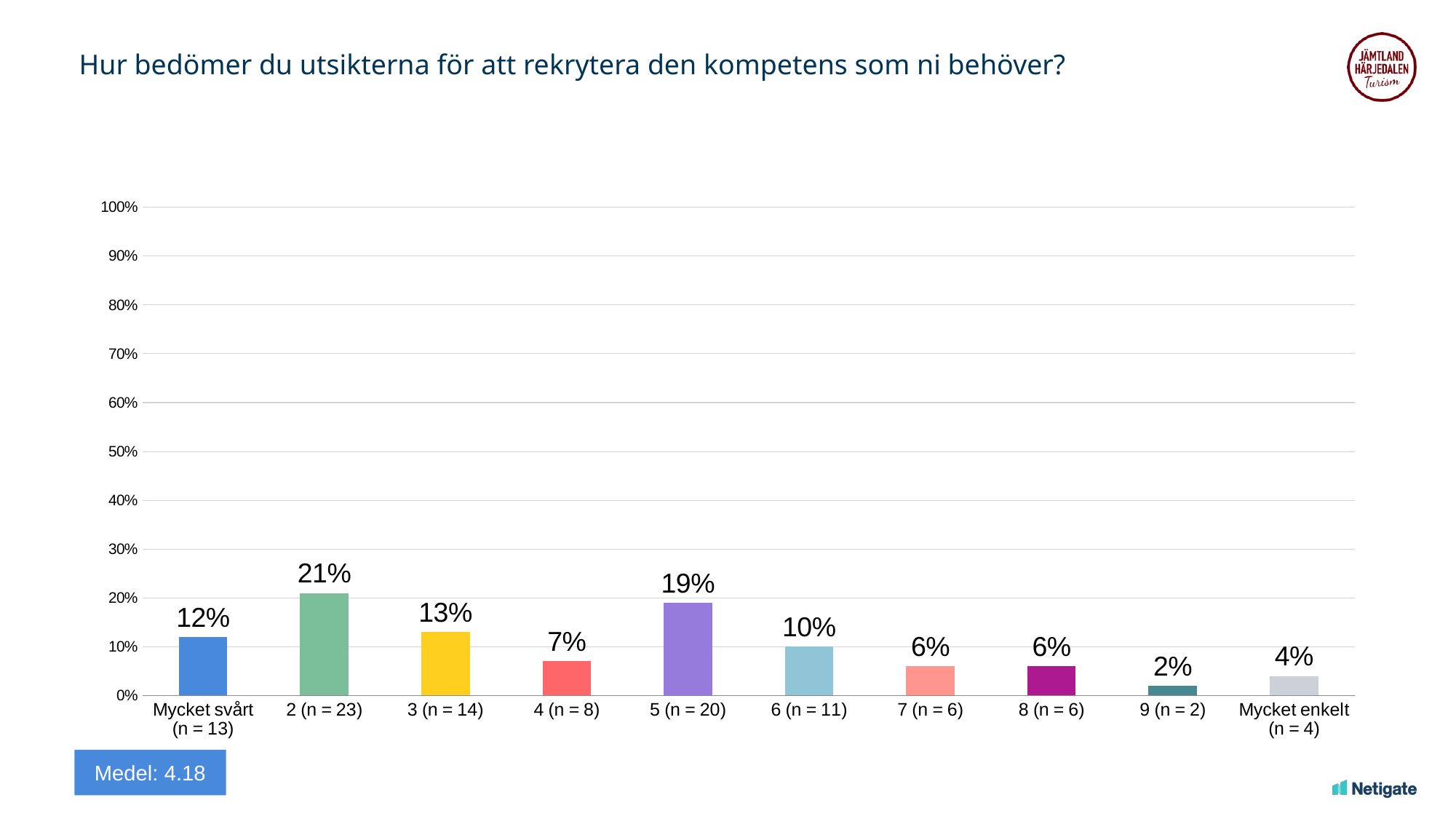
How many categories are shown on the x axis? 10 What kind of chart is shown on the slide? bar chart Is the value for "4 (n = 8)" greater or less than 10%? less What is the value for "Mycket enkelt (n = 4)"? 4% Which category has the lowest value? 9 (n = 2) What is the difference between the values for "2 (n = 23)" and "5 (n = 20)"? 2% What mean value (Medel) is shown on the slide? 4.18 What is the value for "2 (n = 23)"? 21% What is the value for "Mycket svårt (n = 13)"? 12% What is the value for "5 (n = 20)"? 19% Which category has the highest value? 2 (n = 23) Which is larger, the value for "3 (n = 14)" or the value for "6 (n = 11)"? 3 (n = 14)